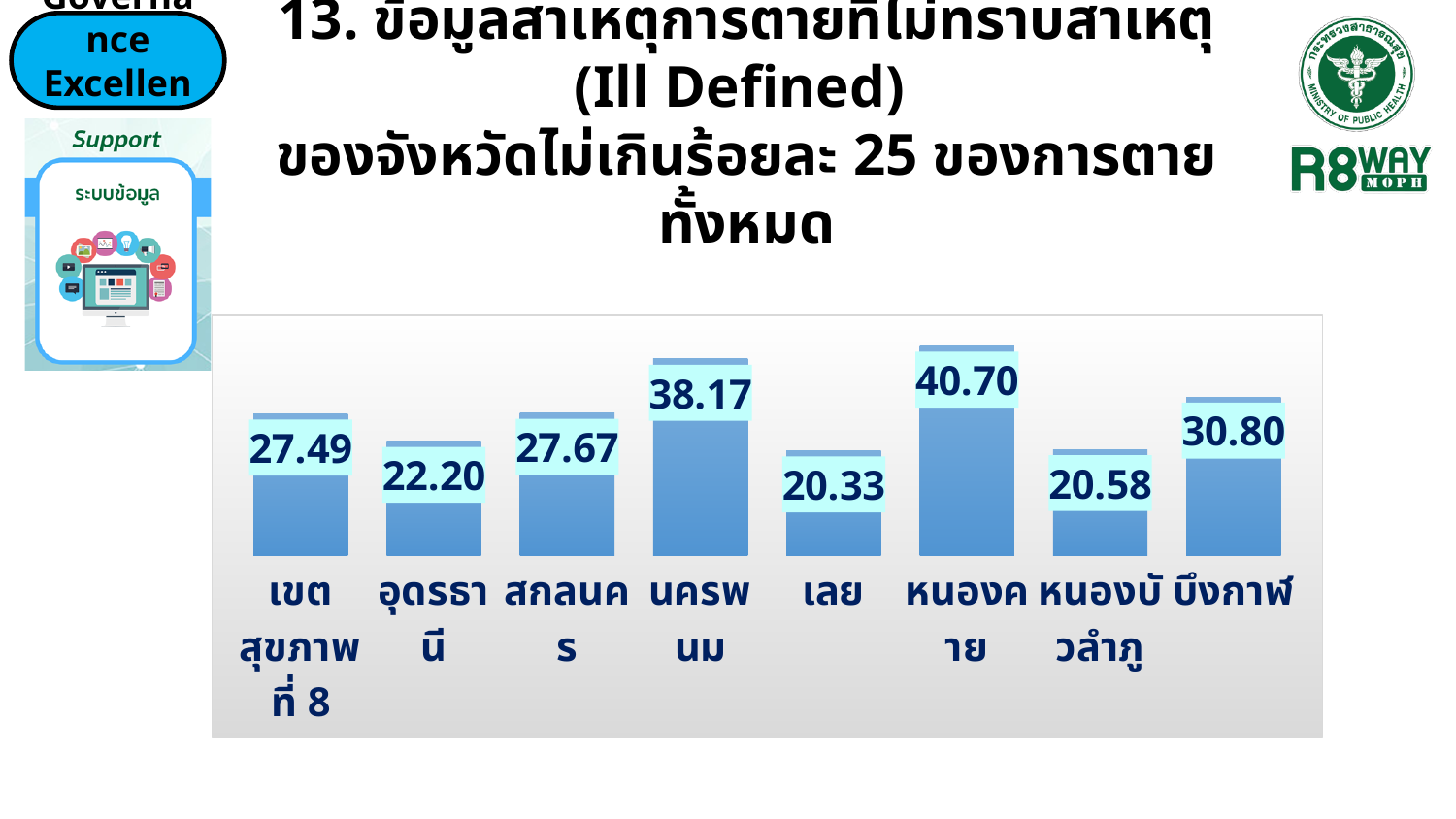
What is the difference between the values for บึงกาฬ and อุดรธานี? 8.60 How many categories are shown in the chart? 8 What is the value shown for เลย? 20.33 What is the difference between the values for หนองคาย and เลย? 20.37 Which is larger, the value for อุดรธานี or the value for สกลนคร? สกลนคร What is the value shown for หนองคาย? 40.70 What is the value shown for เขตสุขภาพที่ 8? 27.49 Which category has the highest value? หนองคาย What kind of chart is shown on the slide? bar chart Which category has the lowest value? เลย What is the value shown for บึงกาฬ? 30.80 Which is larger, the value for นครพนม or the value for บึงกาฬ? นครพนม